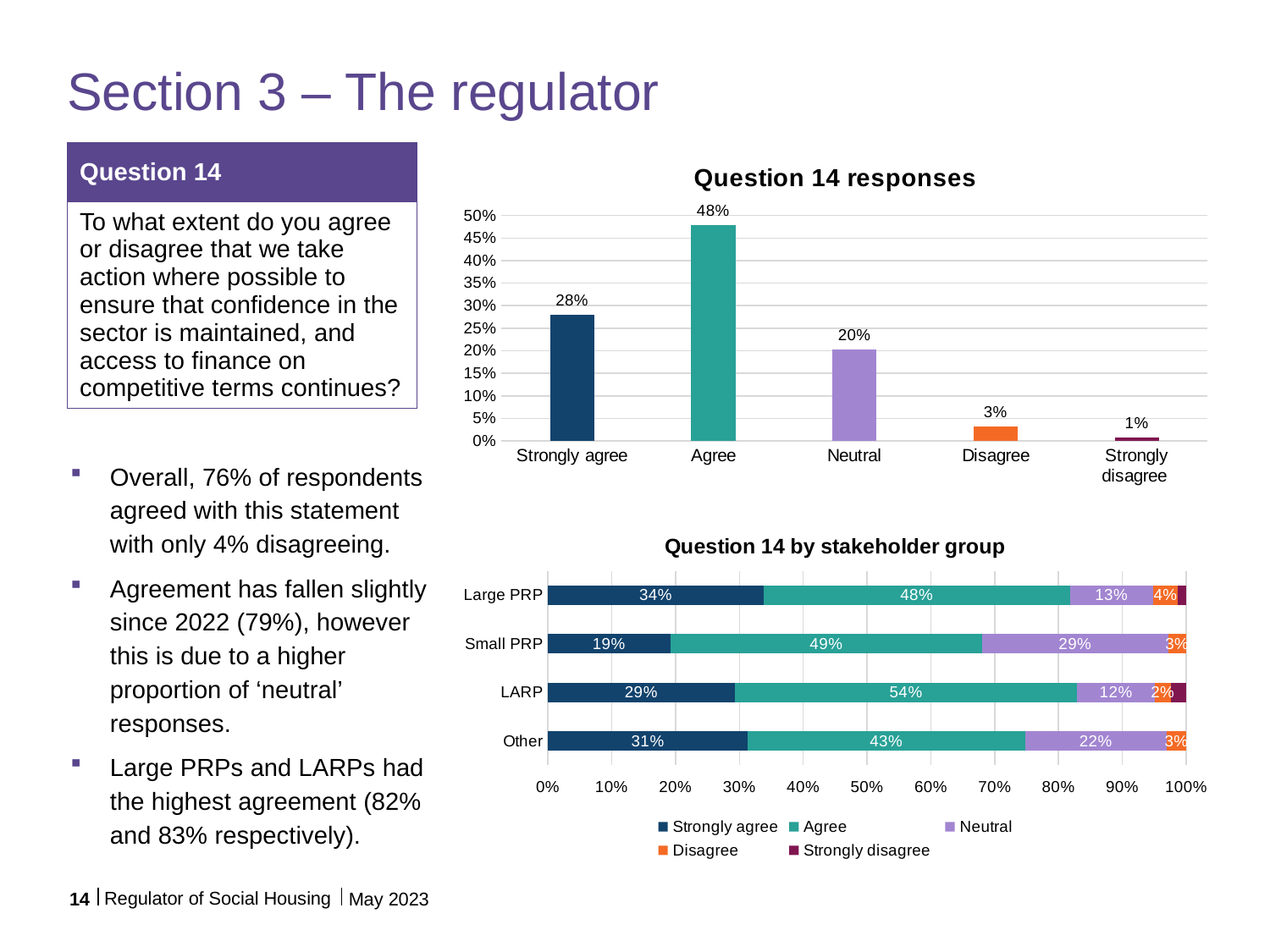
In the 'Question 14 responses' chart, what is the difference between Agree and Strongly agree? 20% In the 'Question 14 by stakeholder group' chart, what is the Agree value for LARP? 54% In the 'Question 14 responses' chart, what is the value for Agree? 48% In the 'Question 14 responses' chart, how many categories are shown on the x axis? 5 In the 'Question 14 responses' chart, which category has the lowest value? Strongly disagree In the 'Question 14 by stakeholder group' chart, is the Strongly agree value for Small PRP larger or smaller than that for Other? Smaller In the 'Question 14 by stakeholder group' chart, what is the Neutral value for Small PRP? 29% In the 'Question 14 responses' chart, which category has the highest value? Agree In the 'Question 14 responses' chart, what is the value for Strongly disagree? 1% What kind of chart is 'Question 14 responses'? Bar chart How many series does the legend of the 'Question 14 by stakeholder group' chart list? 5 In the 'Question 14 by stakeholder group' chart, which stakeholder group has the highest Strongly agree value? Large PRP